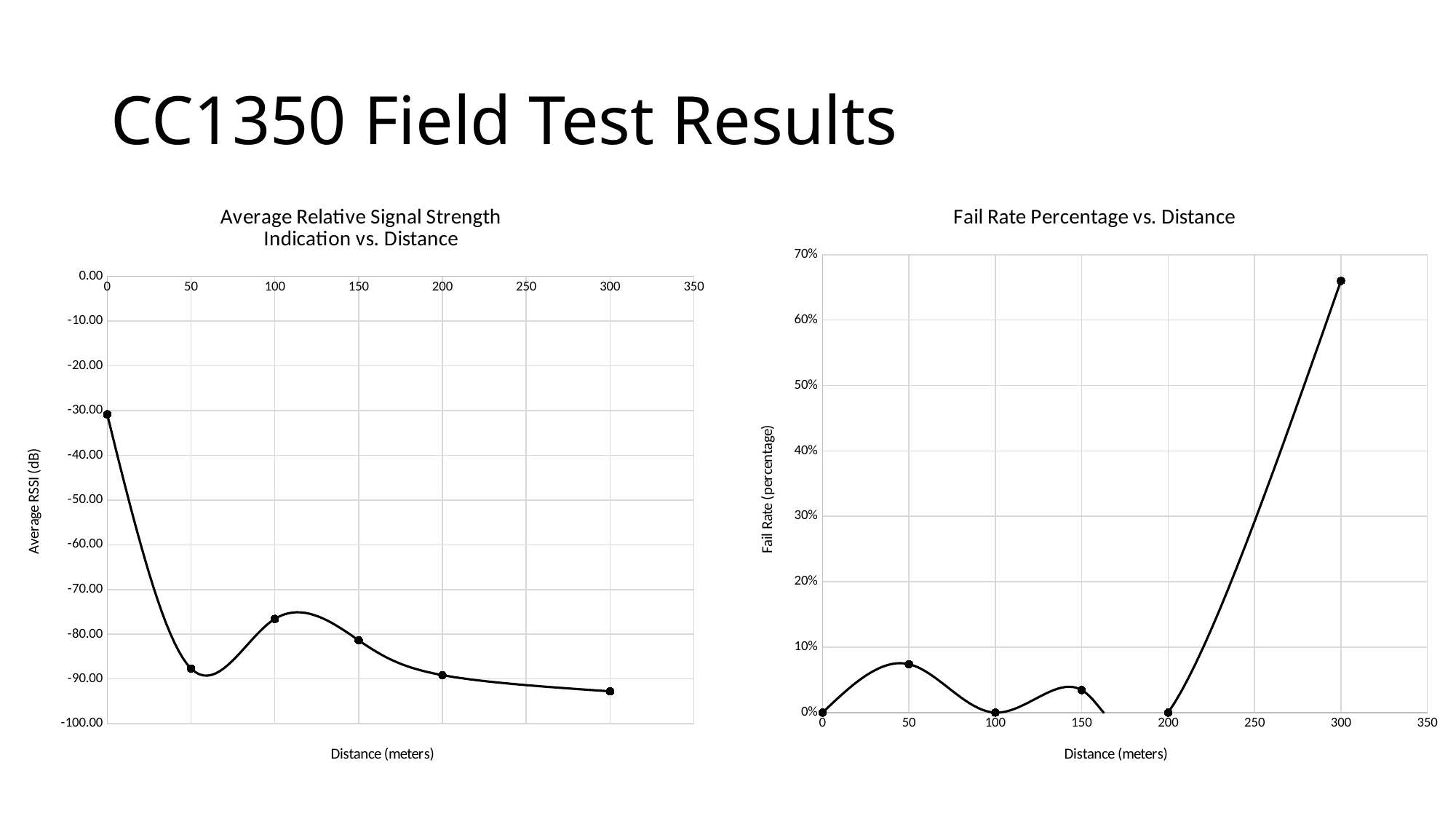
What type of chart is the 'Average Relative Signal Strength Indication vs. Distance' chart? line chart On the 'Average Relative Signal Strength Indication vs. Distance' chart, is the average RSSI at 50 meters greater or less than -80.00? less How many data points are plotted on the 'Average Relative Signal Strength Indication vs. Distance' chart? 6 On the 'Fail Rate Percentage vs. Distance' chart, is the fail rate at 300 meters greater or less than 60%? greater How many data points are plotted on the 'Fail Rate Percentage vs. Distance' chart? 6 What is the y-axis label of the 'Fail Rate Percentage vs. Distance' chart? Fail Rate (percentage) On the 'Average Relative Signal Strength Indication vs. Distance' chart, at which distance is the average RSSI lowest? 300 On the 'Fail Rate Percentage vs. Distance' chart, what is the fail rate at a distance of 100 meters? 0% On the 'Fail Rate Percentage vs. Distance' chart, at which distance is the fail rate highest? 300 On the 'Fail Rate Percentage vs. Distance' chart, which distance has the higher fail rate: 50 meters or 150 meters? 50 meters On the 'Average Relative Signal Strength Indication vs. Distance' chart, at which distance is the average RSSI highest? 0 On the 'Average Relative Signal Strength Indication vs. Distance' chart, which distance has the higher average RSSI: 100 meters or 200 meters? 100 meters